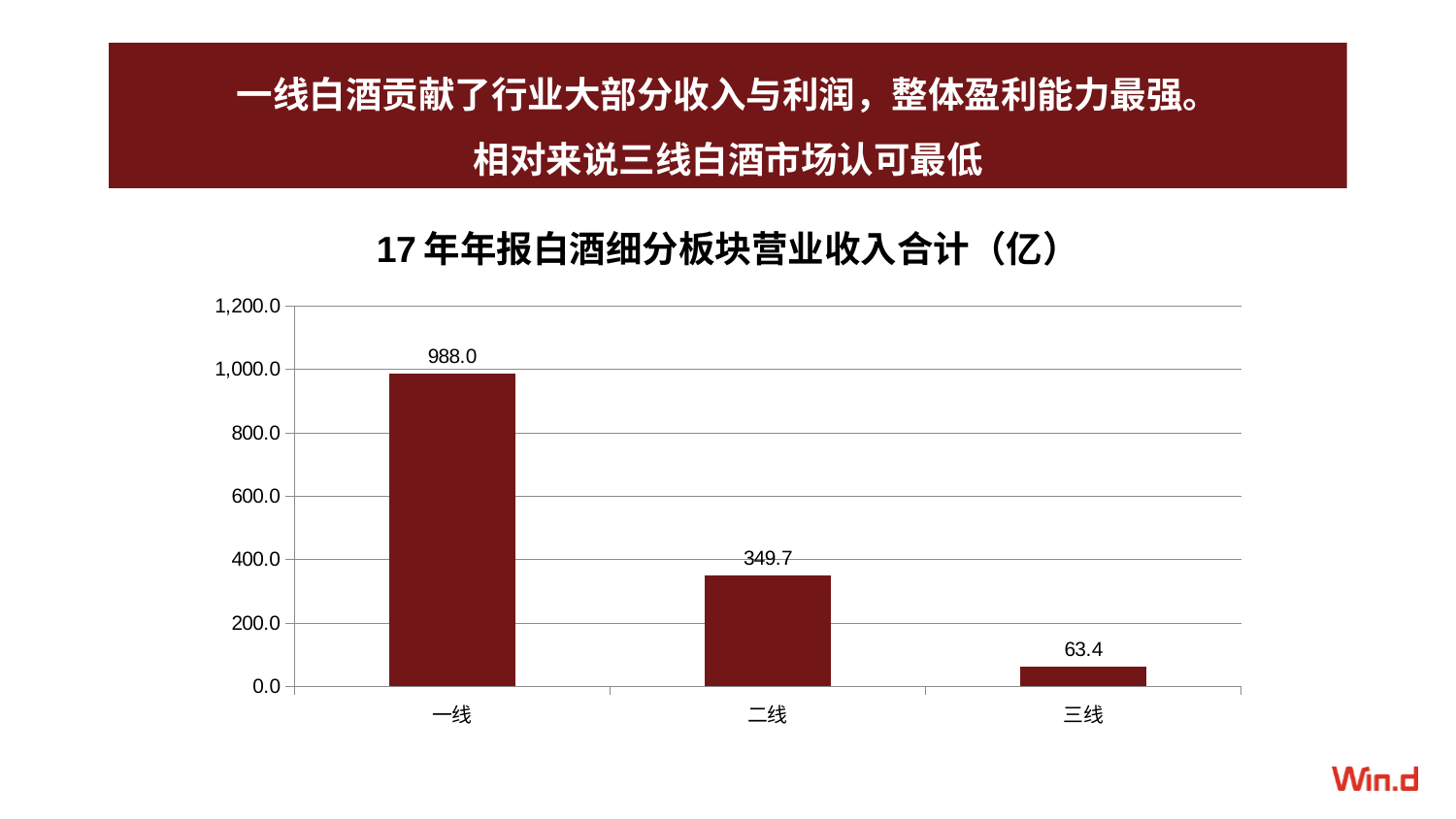
What is the difference between the values for 一线 and 二线? 638.3 What is the value for 三线? 63.4 What is the value for 二线? 349.7 What is the title of the chart? 17 年年报白酒细分板块营业收入合计（亿） Is the value for 二线 greater or less than 400.0? less Which category has the lowest value? 三线 What is the difference between the values for 二线 and 三线? 286.3 Which category has the highest value? 一线 What is the value for 一线? 988.0 How many categories are shown on the x axis? 3 Which is larger, the value for 二线 or the value for 三线? 二线 What kind of chart is shown on the slide? bar chart